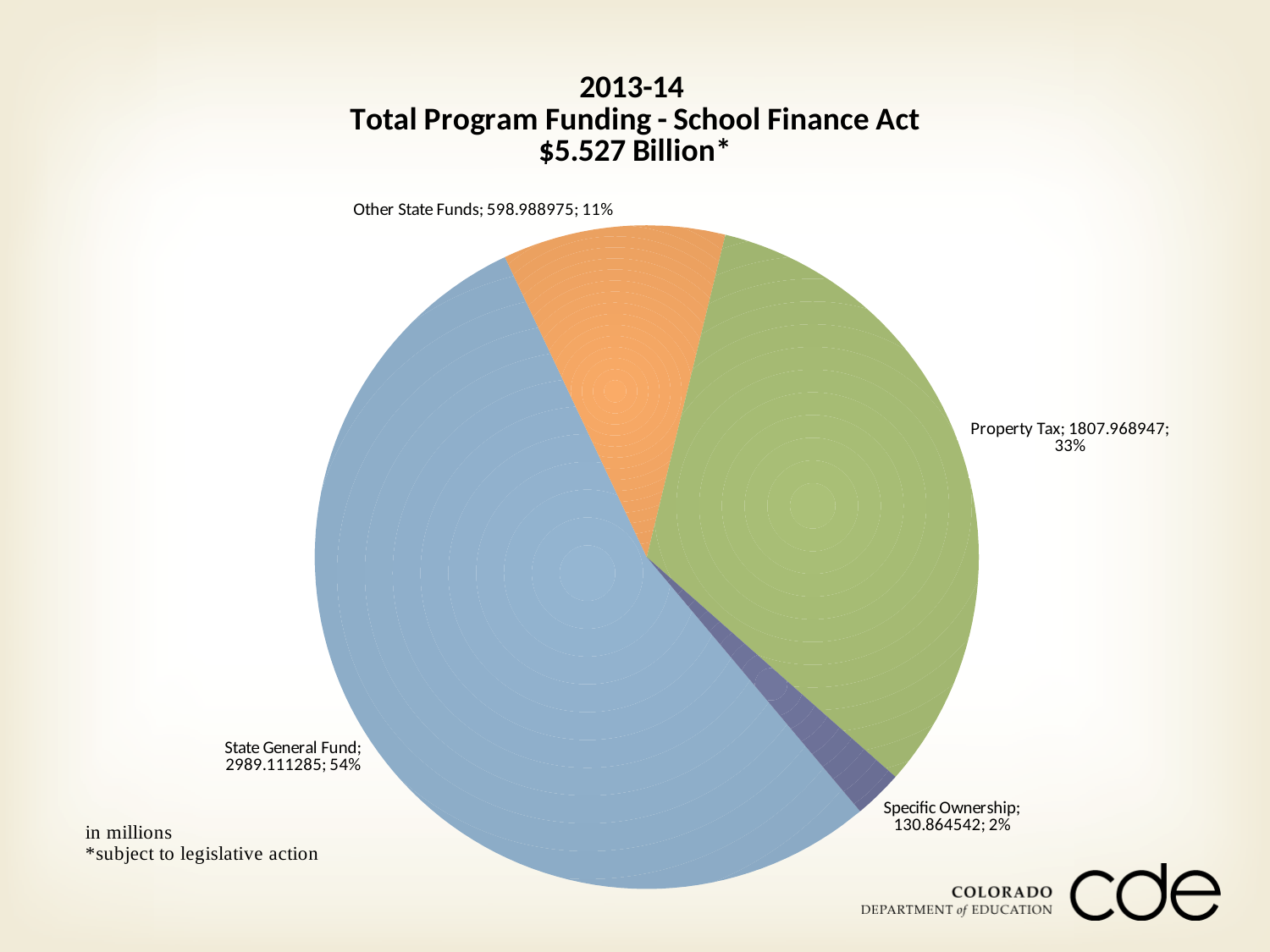
What share of the pie does Property Tax represent? 33% Which category has the largest slice? State General Fund What kind of chart is shown on the slide? pie chart What is the value for Specific Ownership? 130.864542 What is the title of the chart? 2013-14 Total Program Funding - School Finance Act $5.527 Billion* What is the value for Property Tax? 1807.968947 What is the value for State General Fund? 2989.111285 What is the value for Other State Funds? 598.988975 Which is larger, Property Tax or Other State Funds? Property Tax Which category has the smallest slice? Specific Ownership How many slices does the pie chart have? 4 What share of the pie does State General Fund represent? 54%